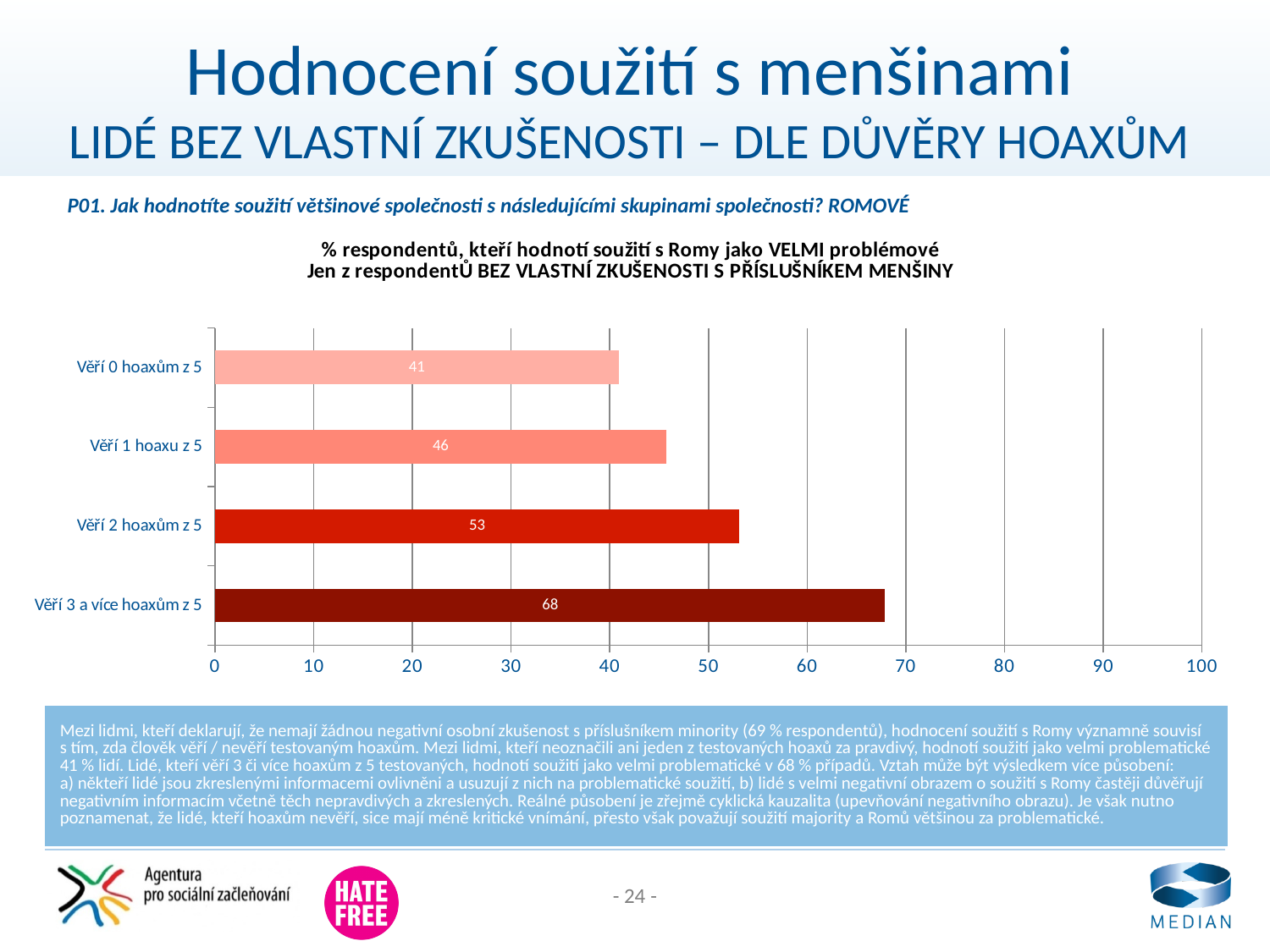
What is the maximum value shown on the horizontal axis? 100 Is the value for "Věří 2 hoaxům z 5" greater or less than 50? greater Which category has the highest value? Věří 3 a více hoaxům z 5 What kind of chart is shown on the slide? bar chart What is the value for "Věří 0 hoaxům z 5"? 41 Which category has the lowest value? Věří 0 hoaxům z 5 What is the value for "Věří 1 hoaxu z 5"? 46 How many categories are shown in the chart? 4 Which is larger, the value for "Věří 1 hoaxu z 5" or "Věří 2 hoaxům z 5"? Věří 2 hoaxům z 5 What is the value for "Věří 3 a více hoaxům z 5"? 68 What is the difference between the values for "Věří 3 a více hoaxům z 5" and "Věří 0 hoaxům z 5"? 27 What is the value for "Věří 2 hoaxům z 5"? 53